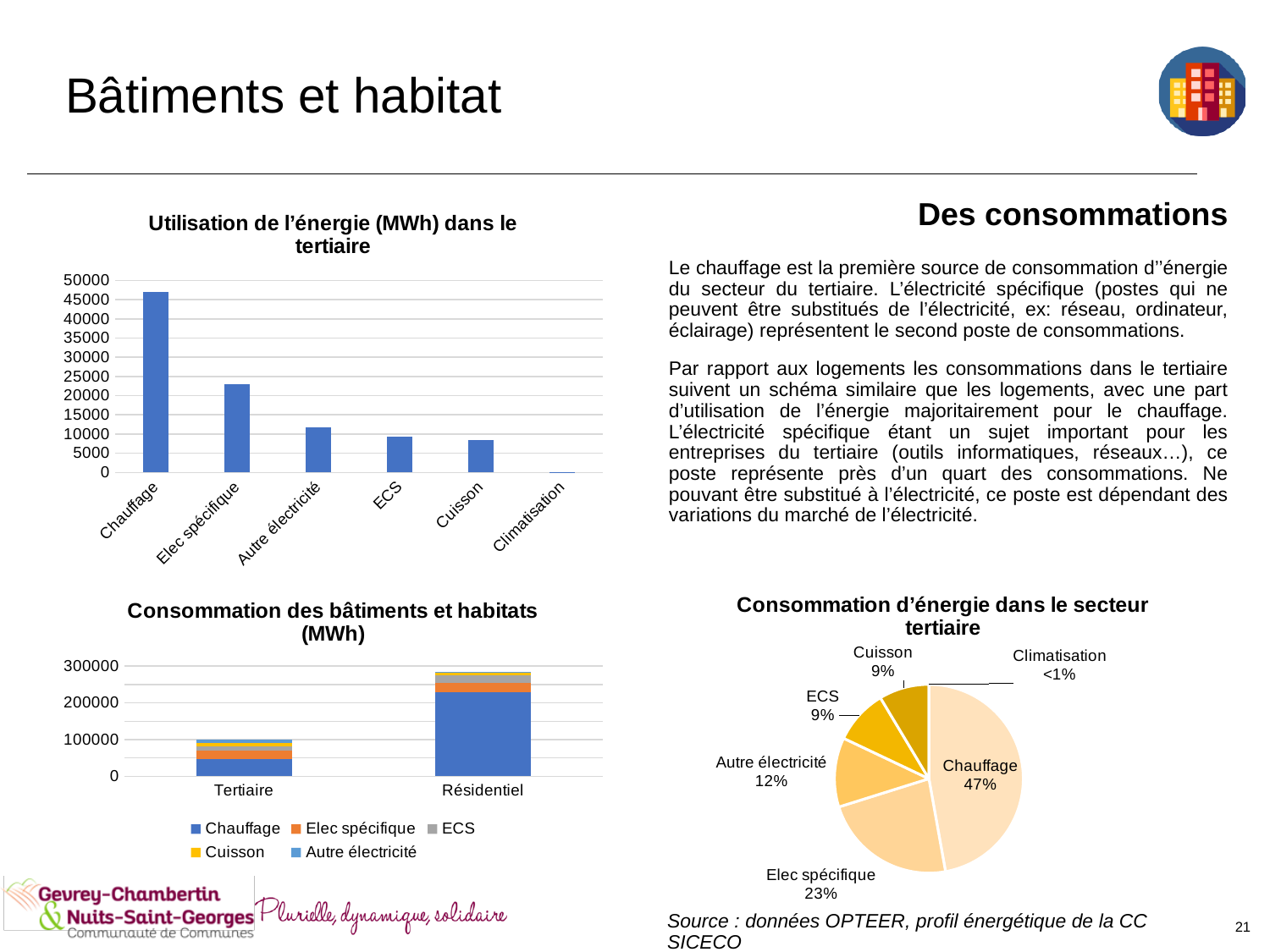
In the bar chart 'Utilisation de l'énergie (MWh) dans le tertiaire', is the value for Chauffage greater or less than 45000? greater In the pie chart 'Consommation d'énergie dans le secteur tertiaire', what share does Elec spécifique represent? 23% In the pie chart 'Consommation d'énergie dans le secteur tertiaire', which slice is the smallest? Climatisation In the stacked bar chart 'Consommation des bâtiments et habitats (MWh)', how many series does the legend list? 5 In the pie chart 'Consommation d'énergie dans le secteur tertiaire', how many percentage points larger is Chauffage than Elec spécifique? 24 In the bar chart 'Utilisation de l'énergie (MWh) dans le tertiaire', which category has the lowest value? Climatisation In the pie chart 'Consommation d'énergie dans le secteur tertiaire', which slice is the largest? Chauffage In the bar chart 'Utilisation de l'énergie (MWh) dans le tertiaire', which category has the highest value? Chauffage In the stacked bar chart 'Consommation des bâtiments et habitats (MWh)', which category has the larger total, Tertiaire or Résidentiel? Résidentiel In the bar chart 'Utilisation de l'énergie (MWh) dans le tertiaire', how many categories are shown on the x axis? 6 In the pie chart 'Consommation d'énergie dans le secteur tertiaire', what share does Chauffage represent? 47% In the pie chart 'Consommation d'énergie dans le secteur tertiaire', what share does Autre électricité represent? 12%